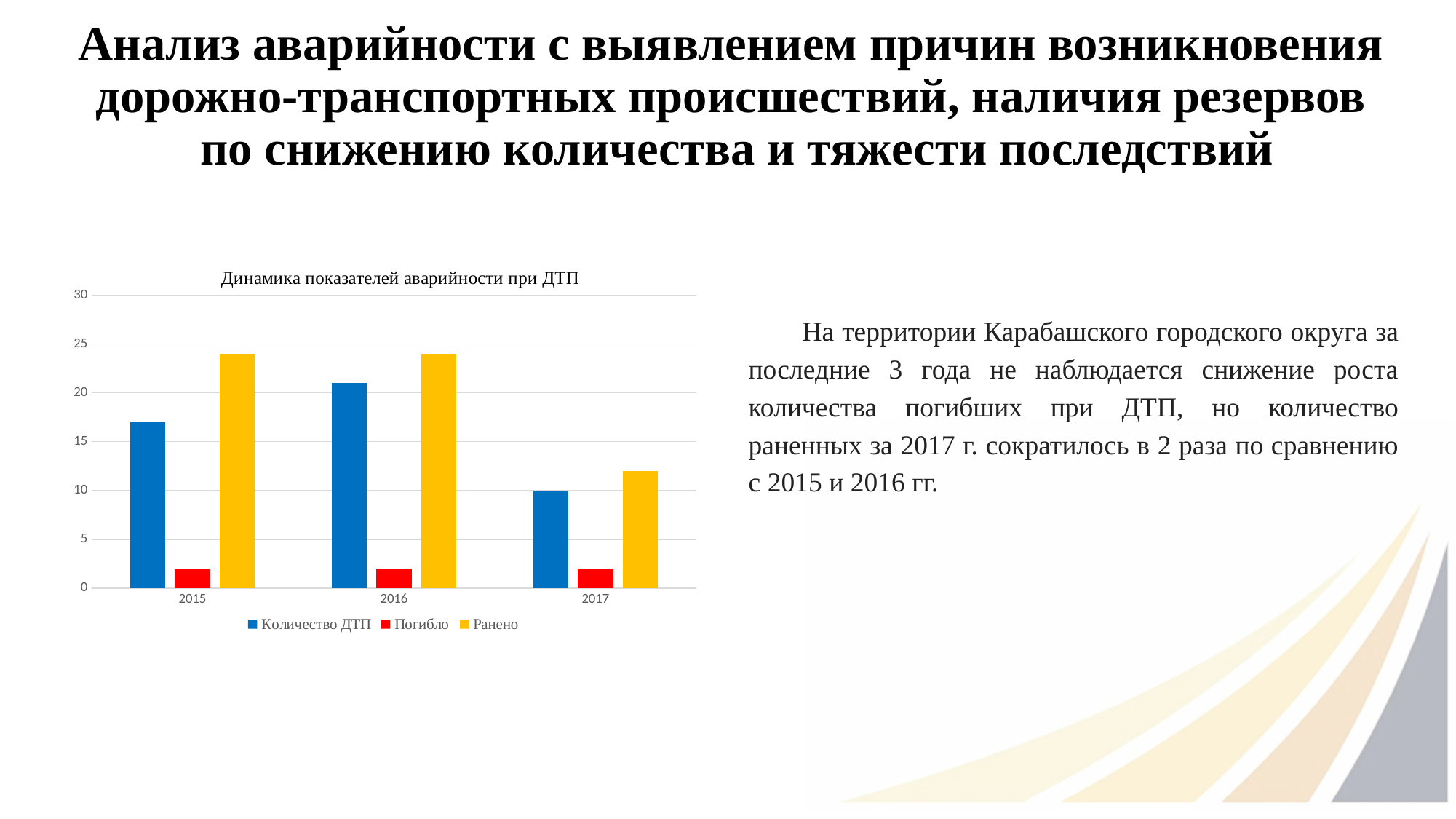
Which year has the lowest value for Ранено? 2017 Which is larger in 2017: Количество ДТП or Ранено? Ранено What type of chart is shown on the slide? bar chart Is the value for Ранено in 2015 greater or less than 20? greater How many years are shown on the x axis of the chart? 3 Is the value for Количество ДТП in 2015 greater or less than 15? greater How many series does the chart legend list? 3 Which year has the highest value for Количество ДТП? 2016 Is the value for Количество ДТП in 2016 greater or less than 20? greater Does the value for Ранено rise or fall from 2016 to 2017? fall What is the title of the chart? Динамика показателей аварийности при ДТП